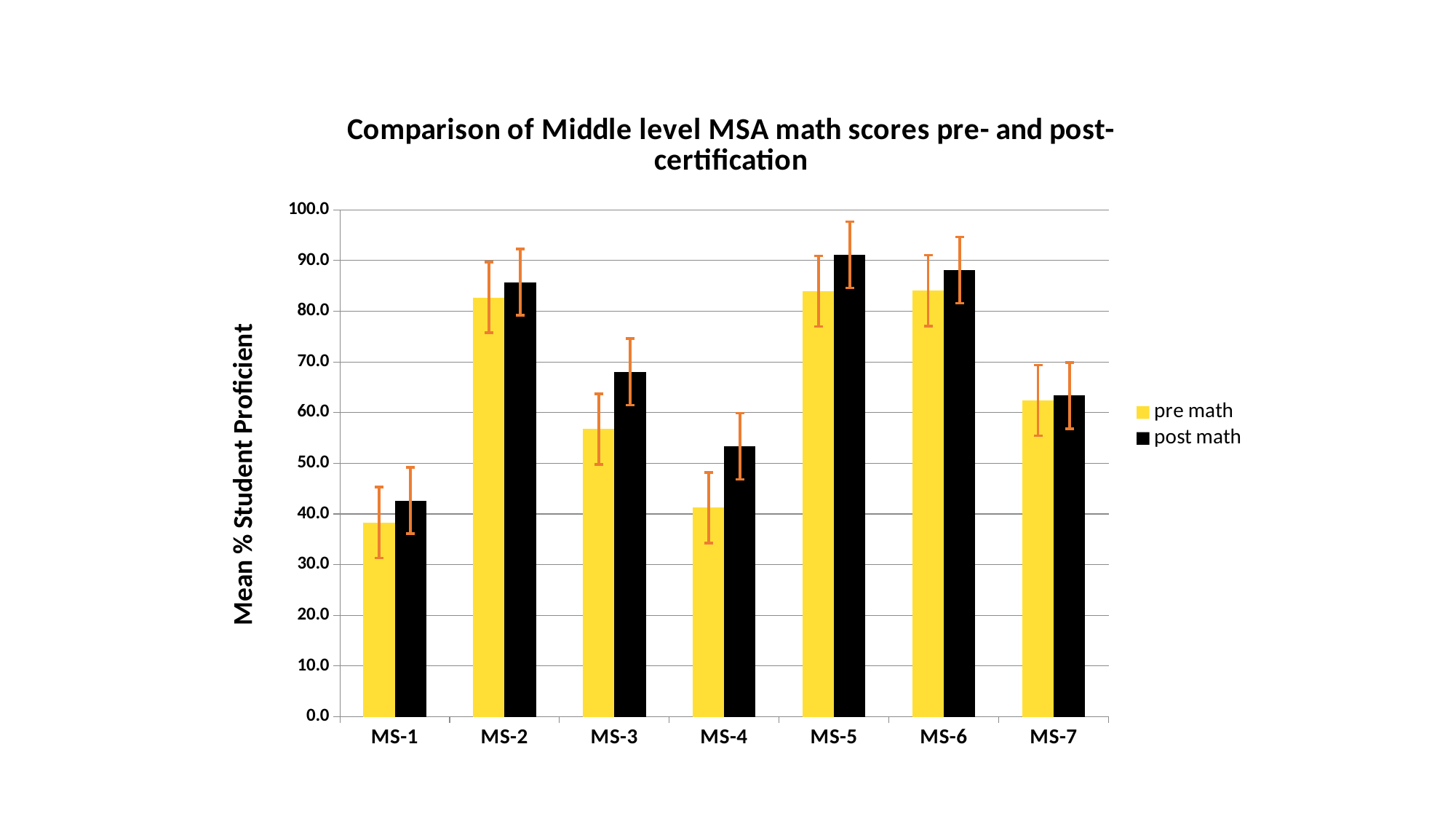
What kind of chart is shown on the slide? bar chart Is the post math value for MS-2 greater or less than 80.0? greater Which school has the highest post math value? MS-5 Which school has the lowest pre math value? MS-1 How many series does the legend list? 2 Is the pre math value for MS-4 greater or less than 50.0? less For MS-4, which is larger: the pre math value or the post math value? post math How many schools (categories) are shown on the x axis? 7 For MS-3, which is larger: the pre math value or the post math value? post math Is the post math value for MS-3 greater or less than 60.0? greater Which school has the lowest post math value? MS-1 What is the label of the y axis? Mean % Student Proficient